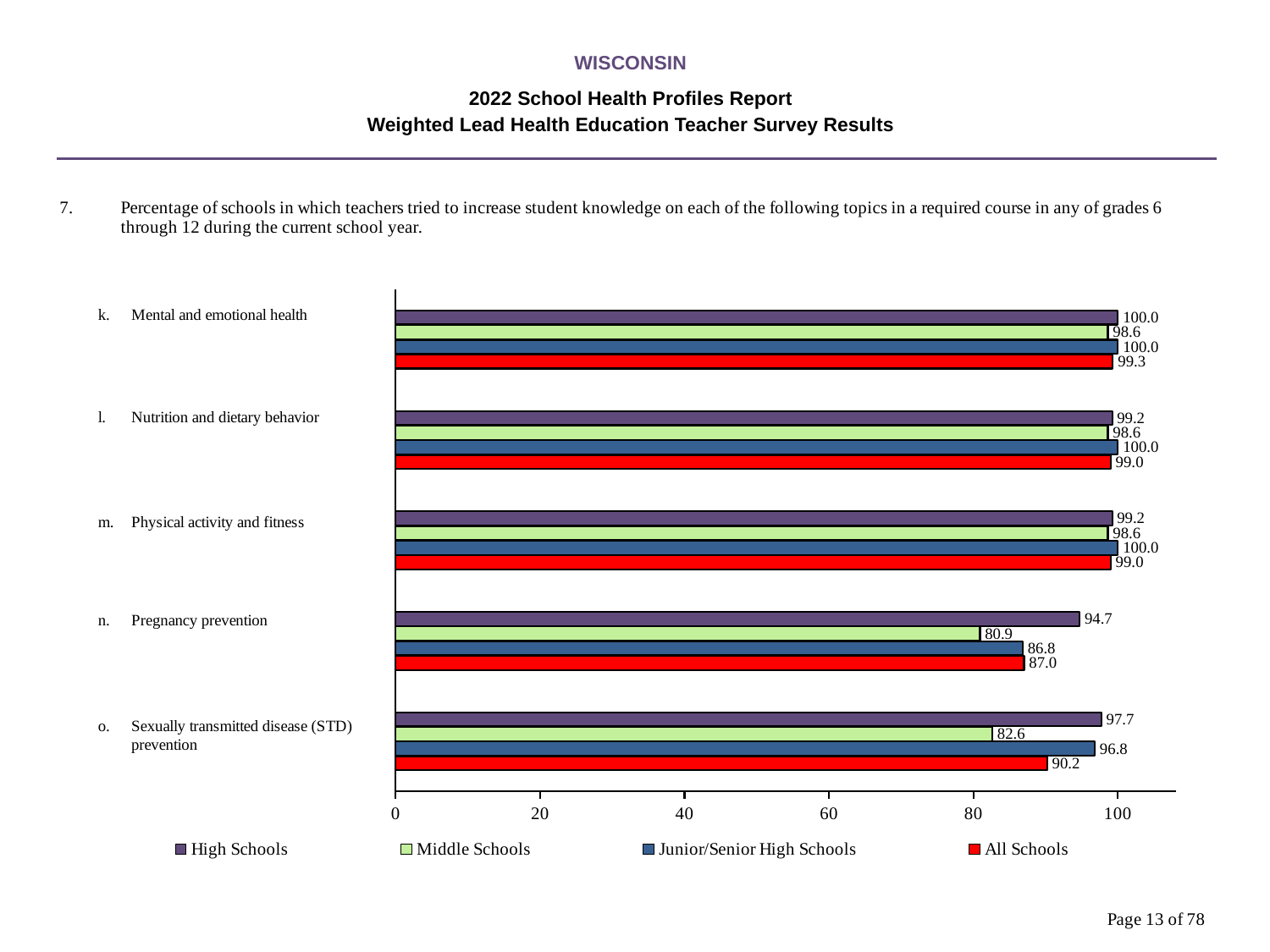
What is the difference between the High Schools and Middle Schools values for Sexually transmitted disease (STD) prevention? 15.1 What is the value for High Schools for Mental and emotional health? 100.0 What is the value for All Schools for Sexually transmitted disease (STD) prevention? 90.2 Which is larger for Pregnancy prevention: the High Schools value or the Middle Schools value? High Schools How many series does the legend list? 4 Which topic has the lowest value for Middle Schools? Pregnancy prevention Which topic has the lowest value for All Schools? Pregnancy prevention What kind of chart is shown on the slide? Bar chart What is the value for Middle Schools for Pregnancy prevention? 80.9 Which colour represents All Schools in the legend? Red What is the value for Junior/Senior High Schools for Pregnancy prevention? 86.8 How many topics are shown on the chart? 5